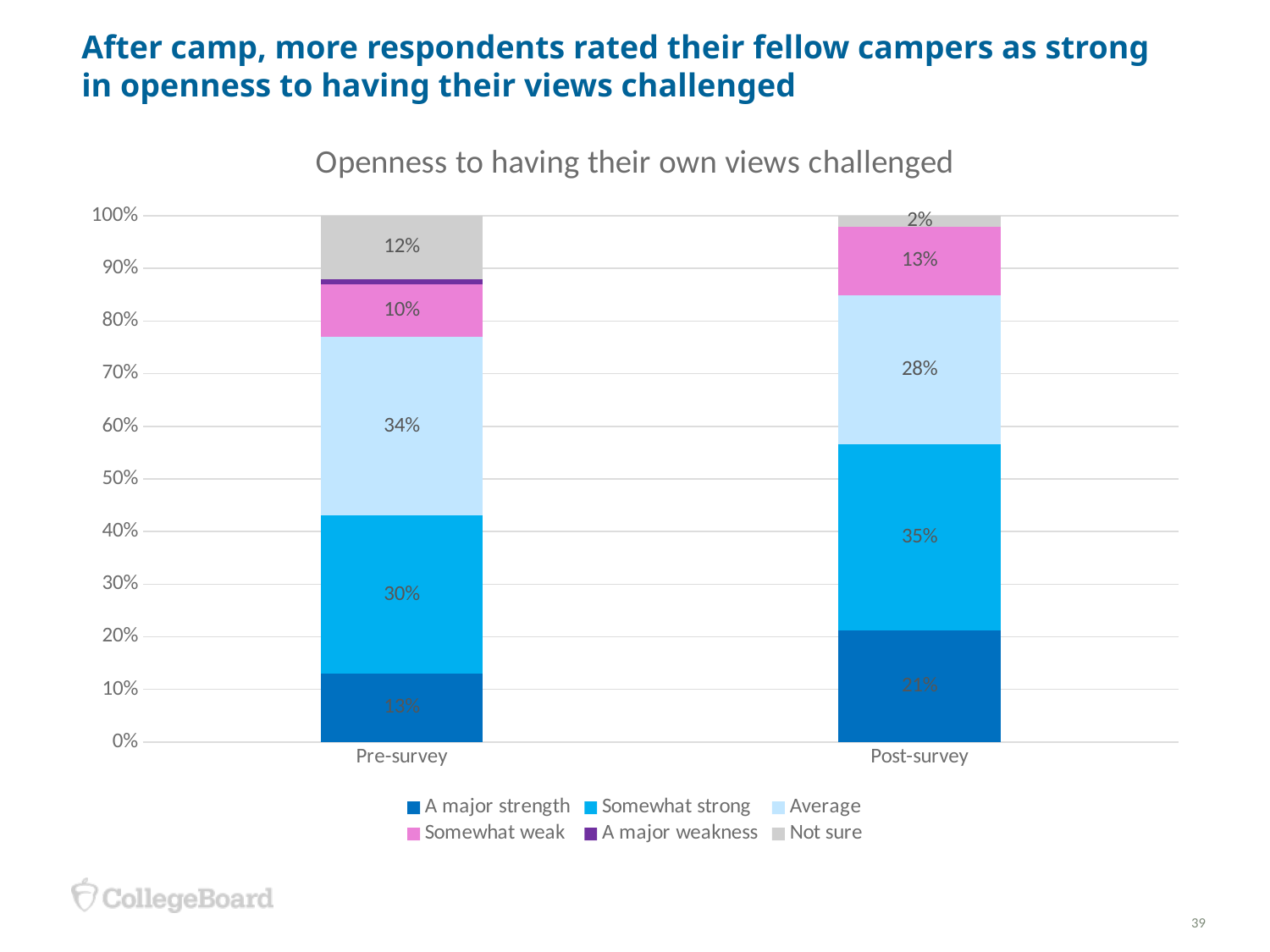
Which survey has the larger 'Average' share, Pre-survey or Post-survey? Pre-survey What is the 'Somewhat weak' value for Post-survey? 13% By how many percentage points did the 'A major strength' share change from Pre-survey to Post-survey? 8 percentage points What percentage of Pre-survey respondents rated their fellow campers as 'Average' in openness to having their views challenged? 34% Which survey has the larger 'Not sure' share, Pre-survey or Post-survey? Pre-survey How many series does the legend list? 6 What is the 'A major strength' value for Post-survey? 21% What kind of chart is shown on the slide? Stacked bar chart What is the title of the chart? Openness to having their own views challenged How many categories are shown on the x axis? 2 What is the 'Not sure' value for Pre-survey? 12% What is the 'Somewhat strong' value for Post-survey? 35%